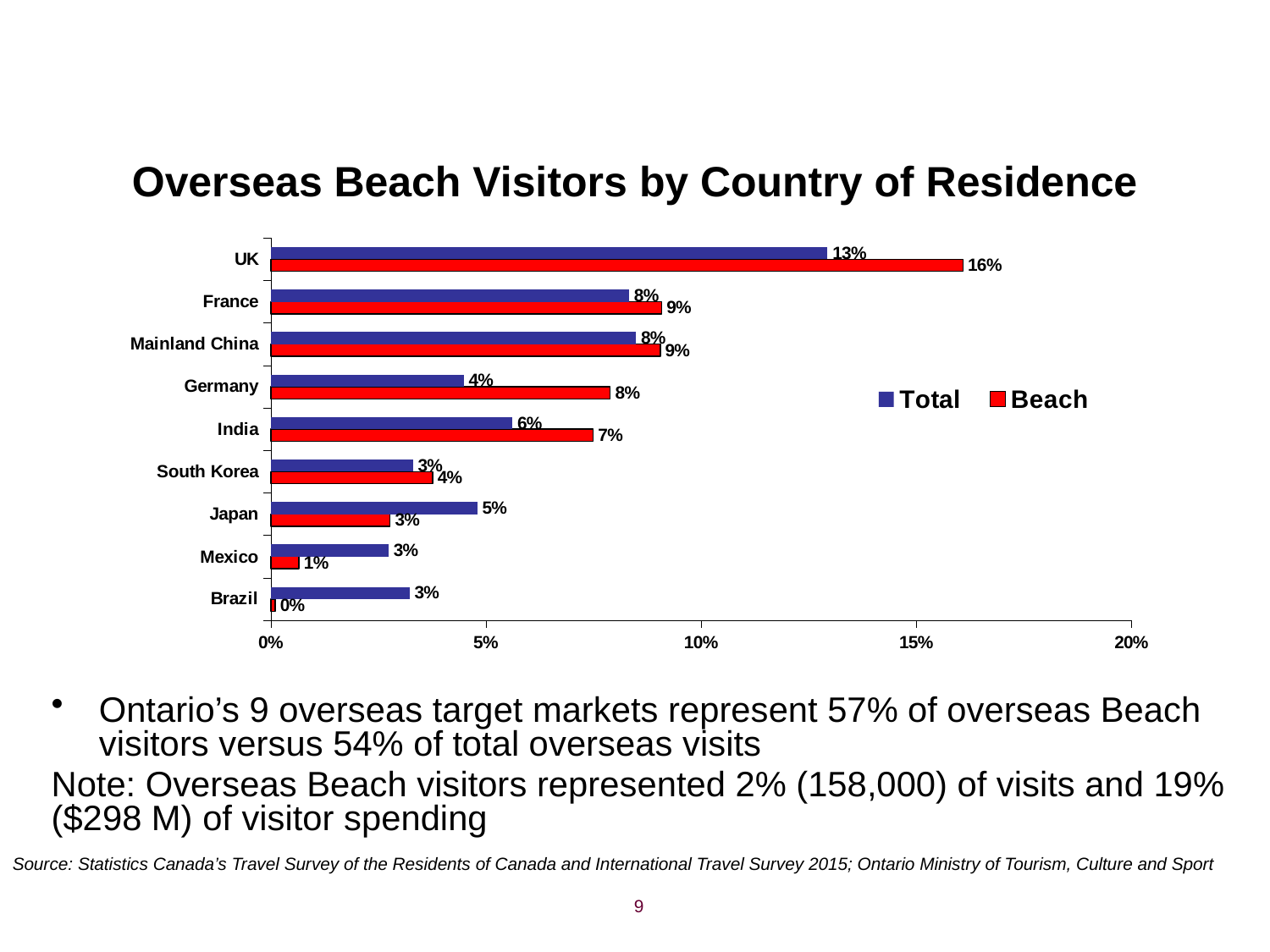
Which country has the highest Beach value? UK Which is larger for Japan, the Total value or the Beach value? Total How many countries are shown on the chart? 9 What is the Beach value for the UK? 16% Is the Beach value for the UK greater or less than 15%? greater What kind of chart is shown on the slide? Bar chart What is the difference between the Beach and Total values for Germany? 4% Which country has the lowest Beach value? Brazil What is the title of the chart? Overseas Beach Visitors by Country of Residence What is the Total value for Germany? 4% What is the Beach value for Mexico? 1% How many series does the legend list? 2